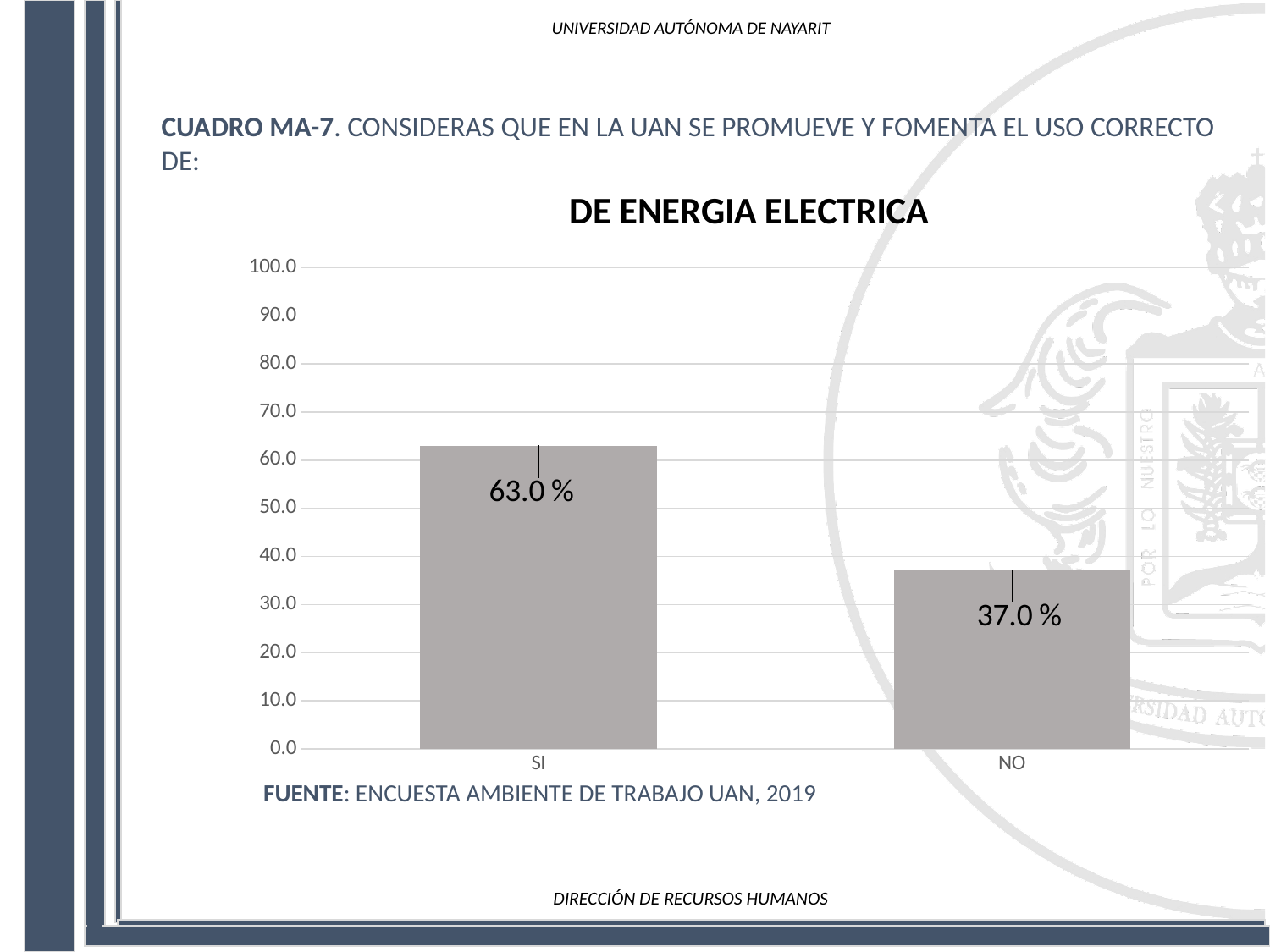
What is the value for NO? 37.0 % Is the value for NO greater or less than 40.0? less Which is larger, the value for SI or the value for NO? SI What is the highest value shown on the vertical axis? 100.0 How many categories are shown in the chart? 2 Which category has the highest value? SI What is the difference between the values for SI and NO? 26.0 % Is the value for SI greater or less than 60.0? greater Which category has the lowest value? NO What is the title of the chart? DE ENERGIA ELECTRICA What kind of chart is shown? bar chart What is the value for SI? 63.0 %